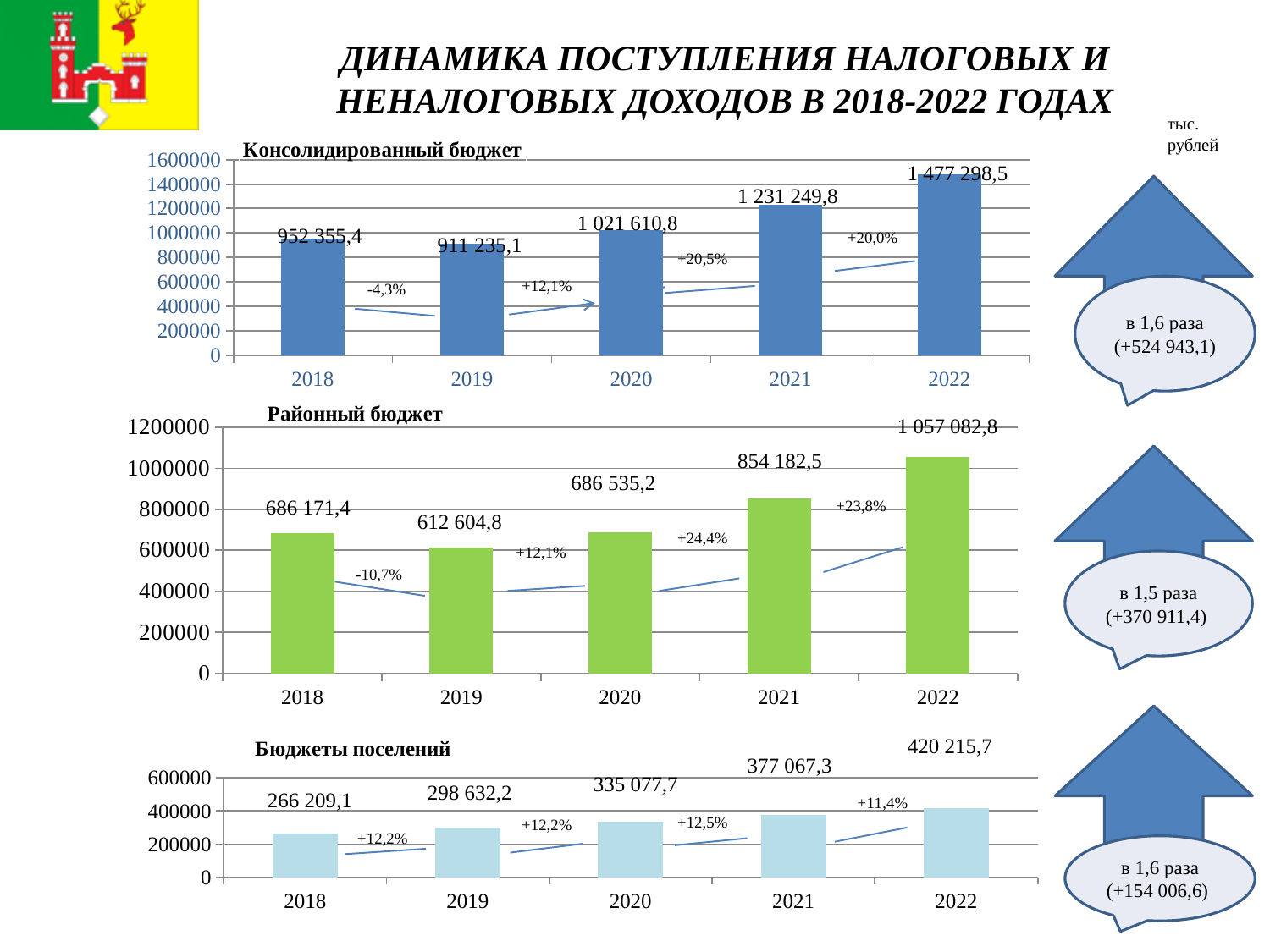
On the 'Консолидированный бюджет' chart, what is the value for 2020? 1 021 610,8 What type of chart is the 'Районный бюджет' chart? bar chart On the 'Консолидированный бюджет' chart, what is the difference between the 2022 and 2018 values? 524 943,1 On the 'Районный бюджет' chart, which year has the lowest value? 2019 On the 'Консолидированный бюджет' chart, what percentage change is shown between 2019 and 2020? +12,1% On the 'Консолидированный бюджет' chart, which year has the lowest value? 2019 On the 'Районный бюджет' chart, what is the value for 2021? 854 182,5 On the 'Бюджеты поселений' chart, do the values rise or fall from 2018 to 2022? rise How many years (categories) are shown on the 'Бюджеты поселений' chart? 5 On the 'Бюджеты поселений' chart, what is the value for 2019? 298 632,2 On the 'Районный бюджет' chart, is the value for 2021 greater or less than 800000? greater On the 'Районный бюджет' chart, what is the difference between the 2022 and 2018 values? 370 911,4